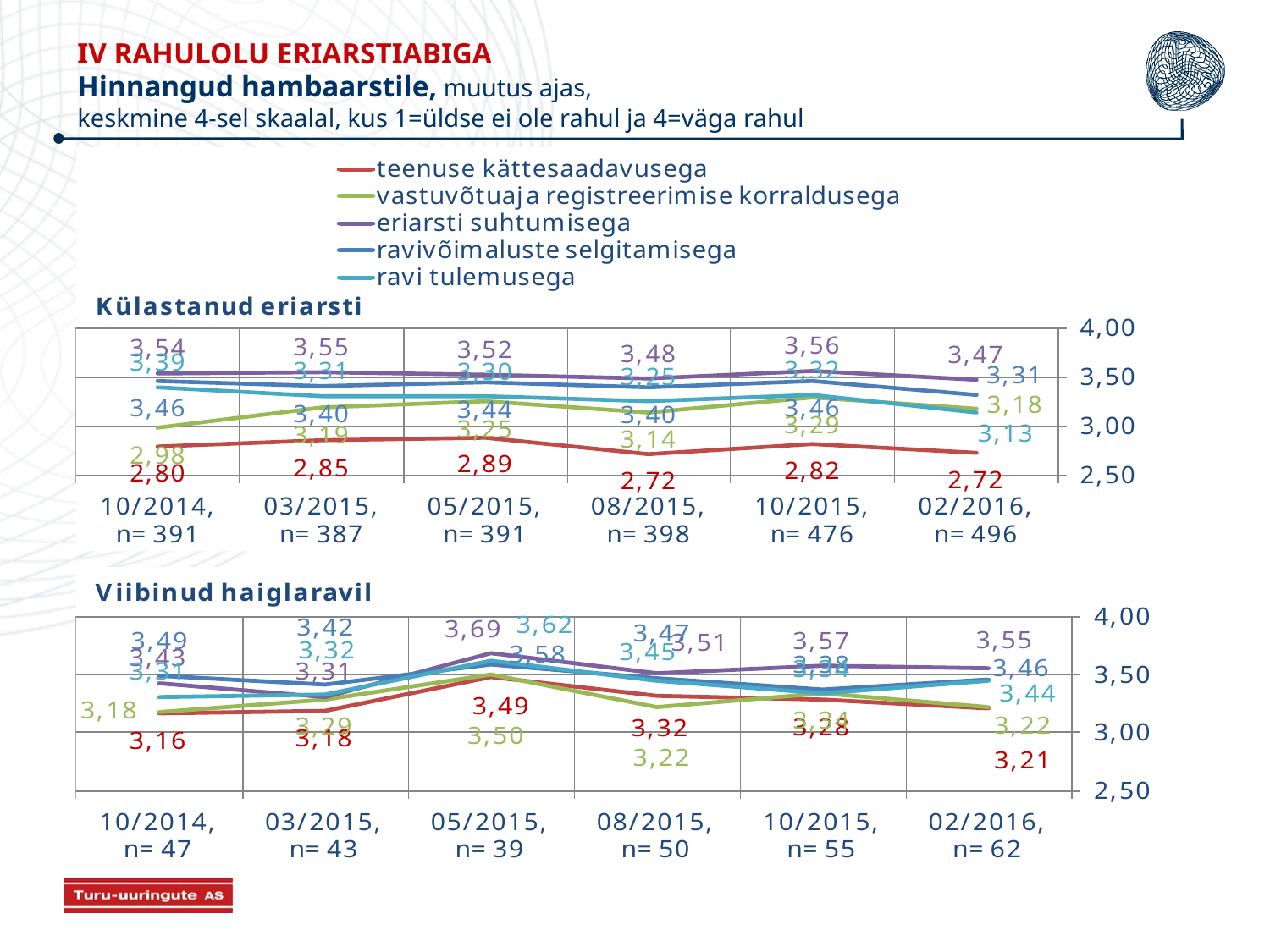
In the 'Viibinud haiglaravil' chart, which is larger for 'teenuse kättesaadavusega': the value at 10/2014 or at 05/2015? 05/2015 In the 'Külastanud eriarsti' chart, what is the value for 'teenuse kättesaadavusega' at 05/2015? 2,89 In the 'Külastanud eriarsti' chart, how many time points are shown on the x axis? 6 What kind of chart is used for 'Külastanud eriarsti'? line chart How many series does the legend list? 5 In the 'Külastanud eriarsti' chart, which series has the lowest value at 10/2014? teenuse kättesaadavusega In the 'Viibinud haiglaravil' chart, what is the value for 'eriarsti suhtumisega' at 05/2015? 3,69 In the 'Külastanud eriarsti' chart, is the value for 'teenuse kättesaadavusega' at 08/2015 greater or less than 3,00? less In the 'Külastanud eriarsti' chart, does 'teenuse kättesaadavusega' rise or fall from 10/2015 to 02/2016? fall In the 'Külastanud eriarsti' chart, what is the value for 'eriarsti suhtumisega' at 10/2015? 3,56 In the 'Külastanud eriarsti' chart, what is the difference between 'eriarsti suhtumisega' (3,54) and 'teenuse kättesaadavusega' (2,80) at 10/2014? 0,74 In the 'Viibinud haiglaravil' chart, at which time point is 'eriarsti suhtumisega' highest? 05/2015